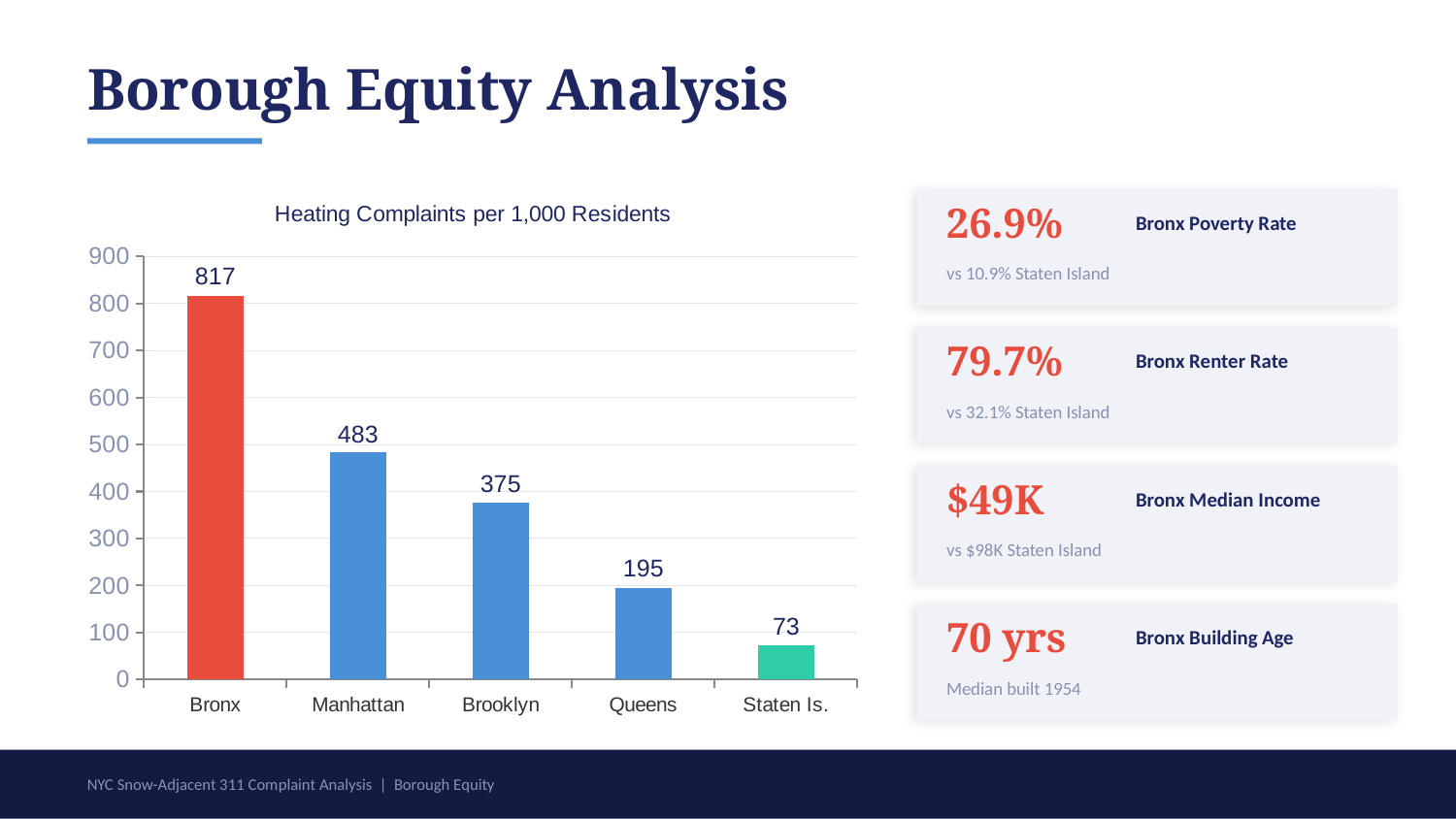
What is the difference between the Manhattan and Brooklyn values in the Heating Complaints per 1,000 Residents chart? 108 What kind of chart is the Heating Complaints per 1,000 Residents chart? Bar chart What is the value for Manhattan in the Heating Complaints per 1,000 Residents chart? 483 Is the value for Queens in the Heating Complaints per 1,000 Residents chart greater or less than 200? less What is the value for Bronx in the Heating Complaints per 1,000 Residents chart? 817 Which borough has the highest heating complaints per 1,000 residents? Bronx What is the value for Staten Is. in the Heating Complaints per 1,000 Residents chart? 73 What is the difference between the Bronx and Staten Is. values in the Heating Complaints per 1,000 Residents chart? 744 Do the values in the Heating Complaints per 1,000 Residents chart rise or fall from left to right? Fall Which borough has the lowest heating complaints per 1,000 residents? Staten Is. How many boroughs are shown in the Heating Complaints per 1,000 Residents chart? 5 Which is larger in the Heating Complaints per 1,000 Residents chart, Brooklyn or Queens? Brooklyn